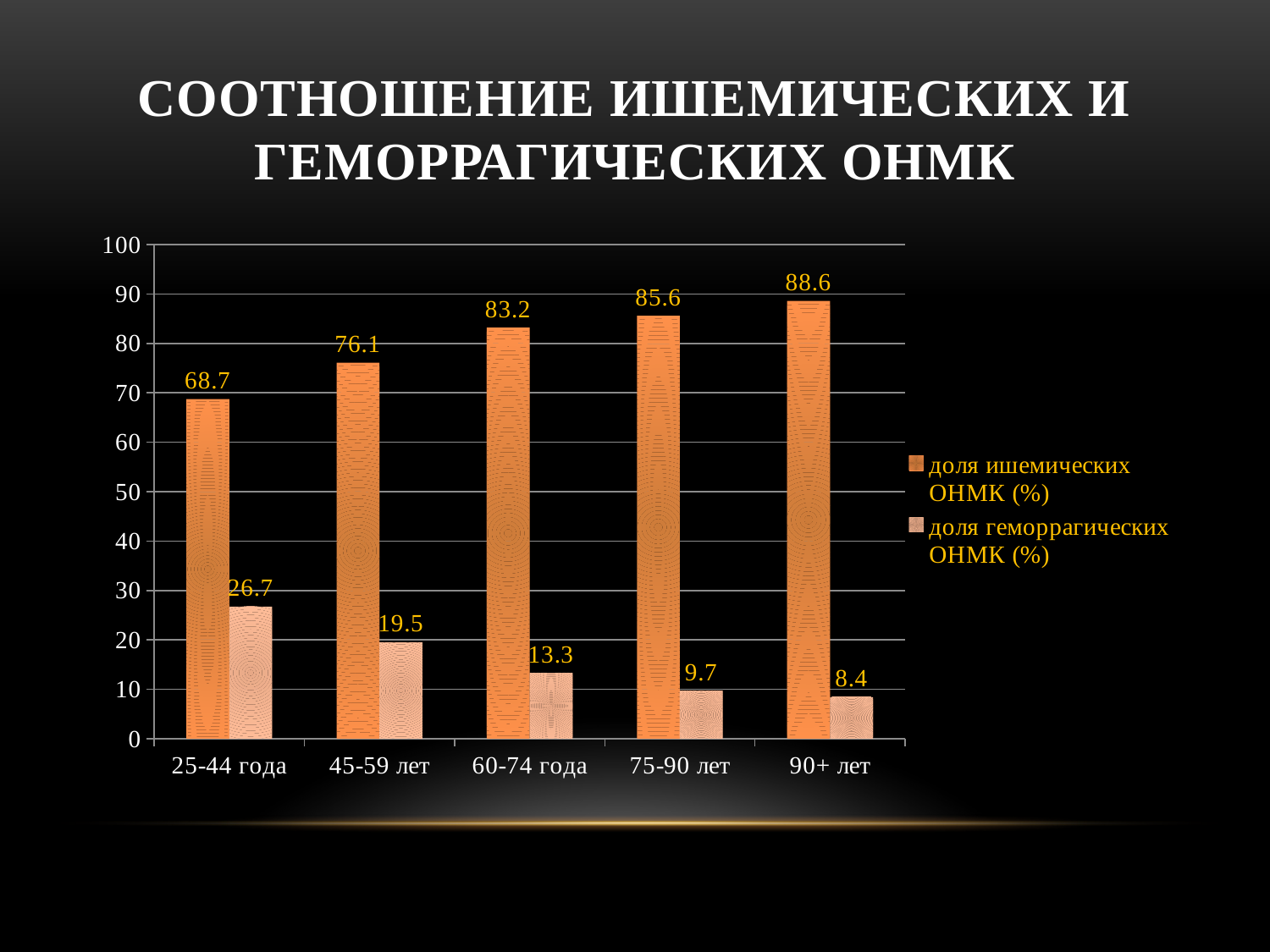
Is the share of ischemic ONMK for the 25-44 года age group greater or less than 70? less What is the share of hemorrhagic ONMK (доля геморрагических ОНМК) for the 90+ лет age group? 8.4 What is the share of ischemic ONMK (доля ишемических ОНМК) for the 60-74 года age group? 83.2 What kind of chart is shown on the slide? bar chart How many age groups are shown on the x axis? 5 What is the difference between the share of ischemic ONMK and the share of hemorrhagic ONMK for the 45-59 лет age group? 56.6 What is the share of hemorrhagic ONMK (доля геморрагических ОНМК) for the 25-44 года age group? 26.7 How many series does the legend list? 2 Which age group has the highest share of ischemic ONMK (доля ишемических ОНМК)? 90+ лет Which age group has the lowest share of hemorrhagic ONMK (доля геморрагических ОНМК)? 90+ лет Which is larger: the share of hemorrhagic ONMK for 25-44 года or for 60-74 года? 25-44 года Does the share of ischemic ONMK (доля ишемических ОНМК) rise or fall as age increases along the x axis? rise